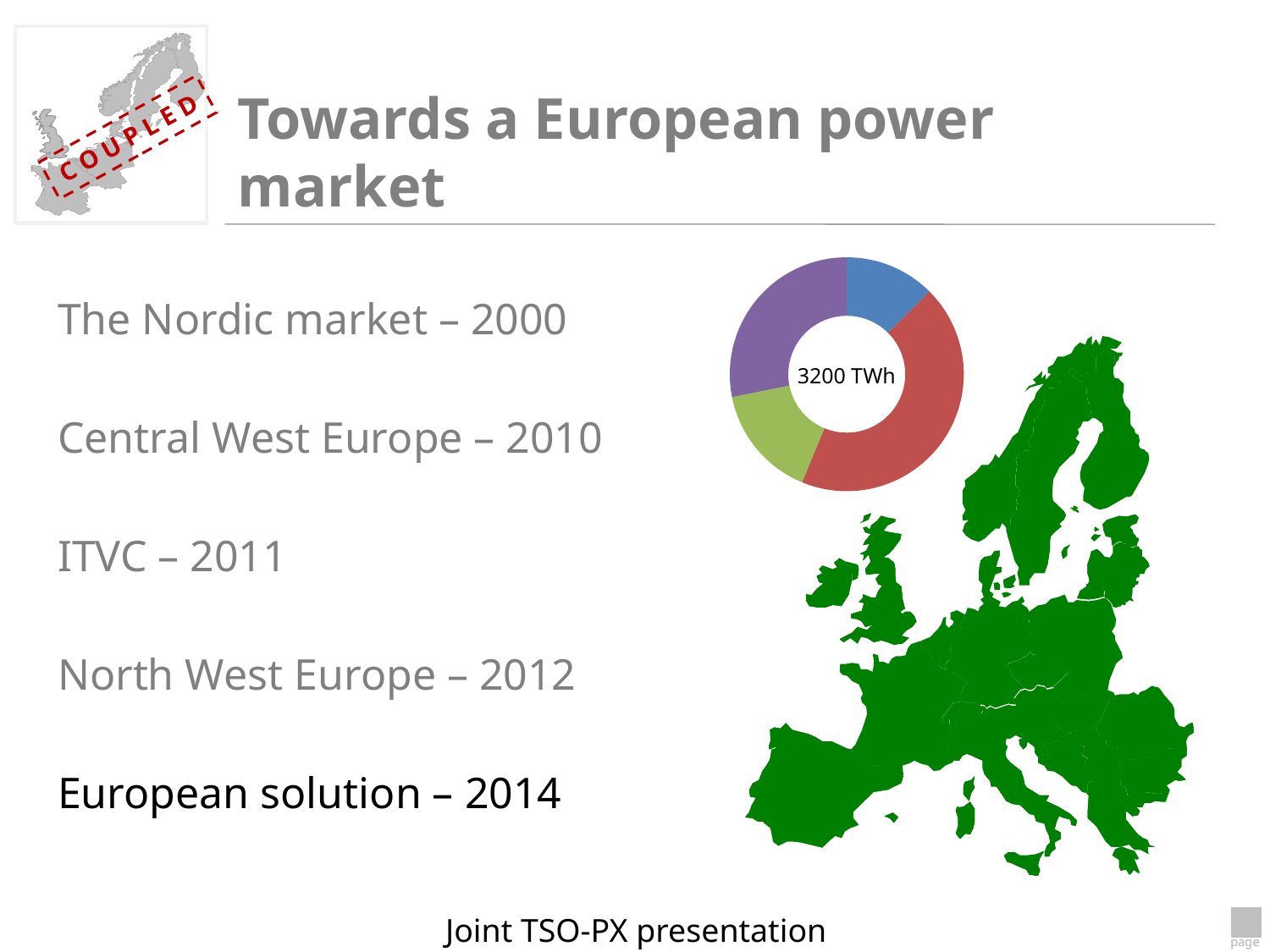
In the doughnut chart, is the purple slice or the green slice larger? purple Which colour slice of the doughnut chart is the smallest? blue In the doughnut chart, is the red slice or the blue slice larger? red How many slices does the doughnut chart have? 4 Does the doughnut chart show a legend identifying its slices? No In the doughnut chart, is the red slice or the purple slice larger? red What kind of chart is shown on the right of the slide? doughnut chart What text is printed in the centre of the doughnut chart? 3200 TWh Which colour slice of the doughnut chart is the largest? red